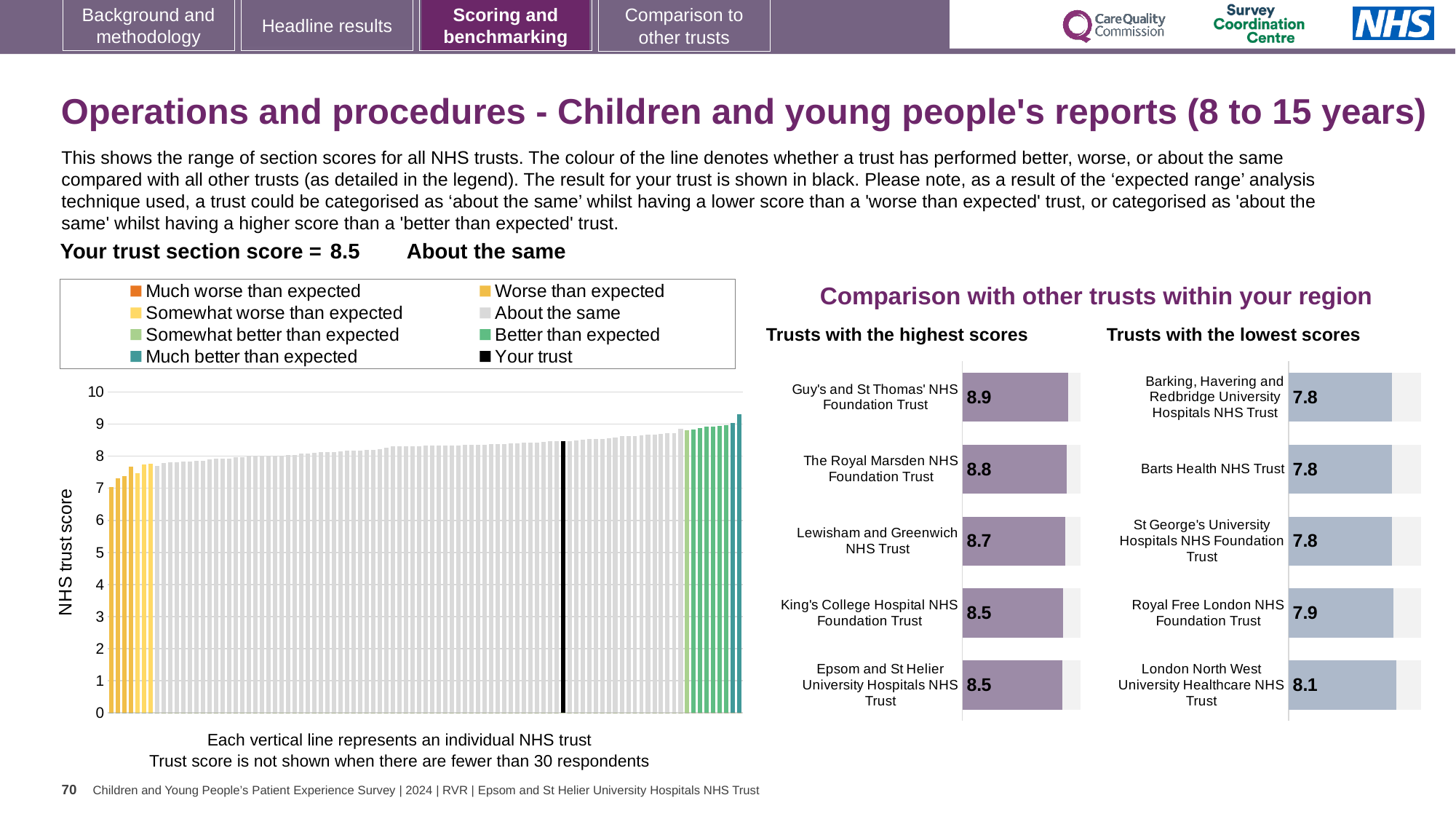
In the 'Trusts with the highest scores' chart, how many trusts are shown? 5 In the 'Trusts with the highest scores' chart, which trust has the highest score? Guy's and St Thomas' NHS Foundation Trust In the 'Trusts with the highest scores' chart, what is the score for Guy's and St Thomas' NHS Foundation Trust? 8.9 What is the y-axis label of the large chart on the left? NHS trust score In the large chart on the left, do the bar values rise or fall from left to right? rise In the large chart on the left, is the value of the black bar (your trust) greater or less than 8? greater In the 'Trusts with the highest scores' chart, what is the difference between the scores of Guy's and St Thomas' NHS Foundation Trust and Lewisham and Greenwich NHS Trust? 0.2 What kind of chart is the large chart on the left showing NHS trust scores? bar chart In the 'Trusts with the lowest scores' chart, what is the score for London North West University Healthcare NHS Trust? 8.1 In the 'Trusts with the lowest scores' chart, which has the larger score: Royal Free London NHS Foundation Trust or Barts Health NHS Trust? Royal Free London NHS Foundation Trust In the 'Trusts with the lowest scores' chart, which trust has the highest score? London North West University Healthcare NHS Trust In the large chart on the left, how many entries does the legend list? 8